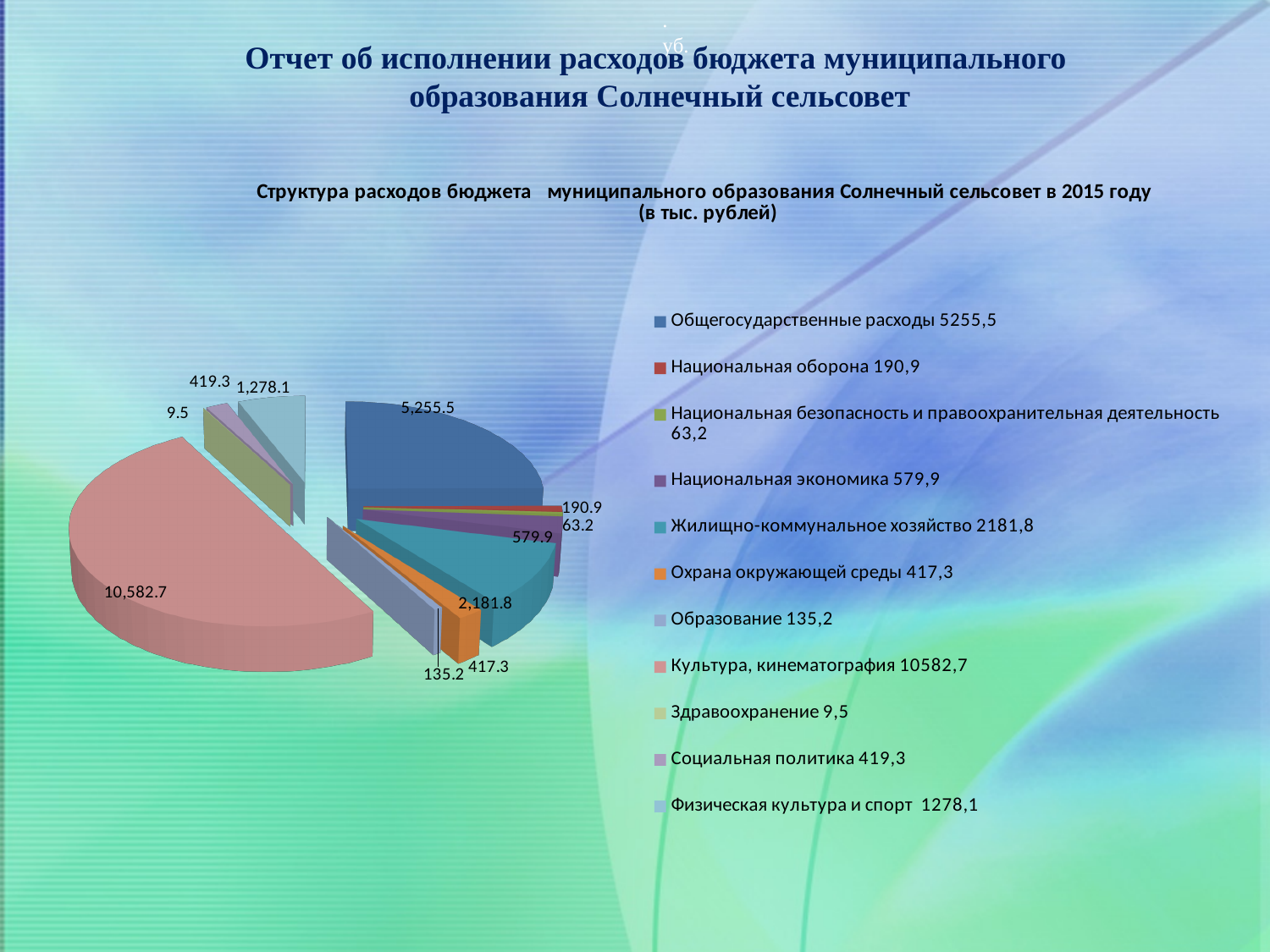
What is the value of the Общегосударственные расходы slice? 5,255.5 Which is larger, the Национальная оборона slice or the Образование slice? Национальная оборона What is the value of the Жилищно-коммунальное хозяйство slice? 2,181.8 How many slices does the pie chart have? 11 What is the difference between the Физическая культура и спорт value and the Национальная экономика value? 698.2 What is the difference between the Общегосударственные расходы value and the Жилищно-коммунальное хозяйство value? 3,073.7 In what units are the values in the chart expressed, according to the chart title? тыс. рублей What kind of chart is shown on the slide? Pie chart Which category has the smallest slice of the pie? Здравоохранение What is the value of the Здравоохранение slice? 9.5 Which category has the largest slice of the pie? Культура, кинематография What is the value of the Культура, кинематография slice? 10,582.7